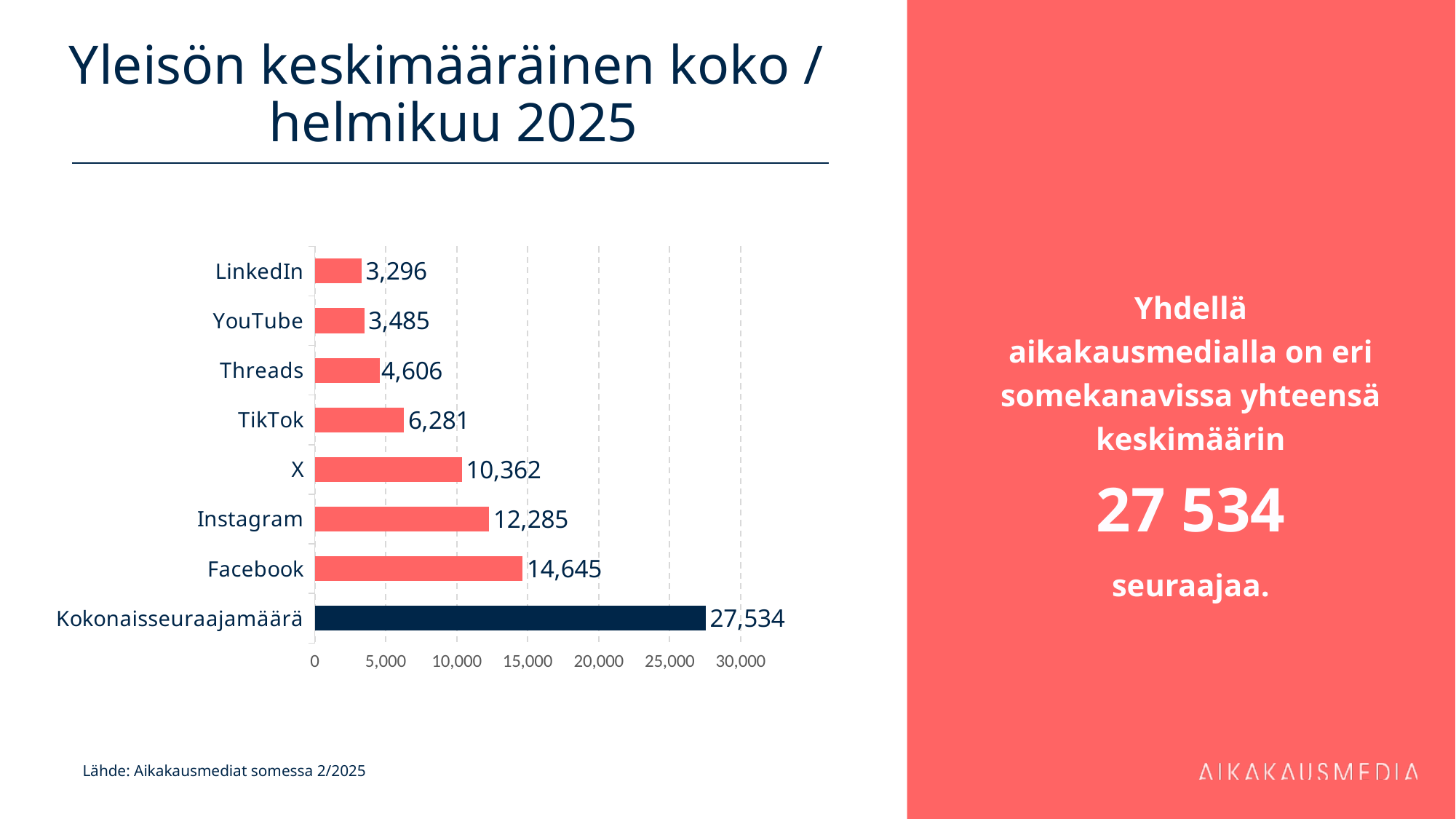
Is the value for X greater or less than 10,000? greater Which platform (excluding the total bar Kokonaisseuraajamäärä) has the highest value? Facebook What is the value for Facebook? 14,645 Which is larger, the value for Threads or the value for YouTube? Threads What is the difference between the values for Instagram and X? 1,923 How many categories are shown in the chart? 8 What is the title of the slide? Yleisön keskimääräinen koko / helmikuu 2025 What kind of chart is shown on the slide? bar chart Which category has the lowest value? LinkedIn Which bar is coloured dark navy instead of red? Kokonaisseuraajamäärä What is the value for Kokonaisseuraajamäärä? 27,534 What is the value for TikTok? 6,281